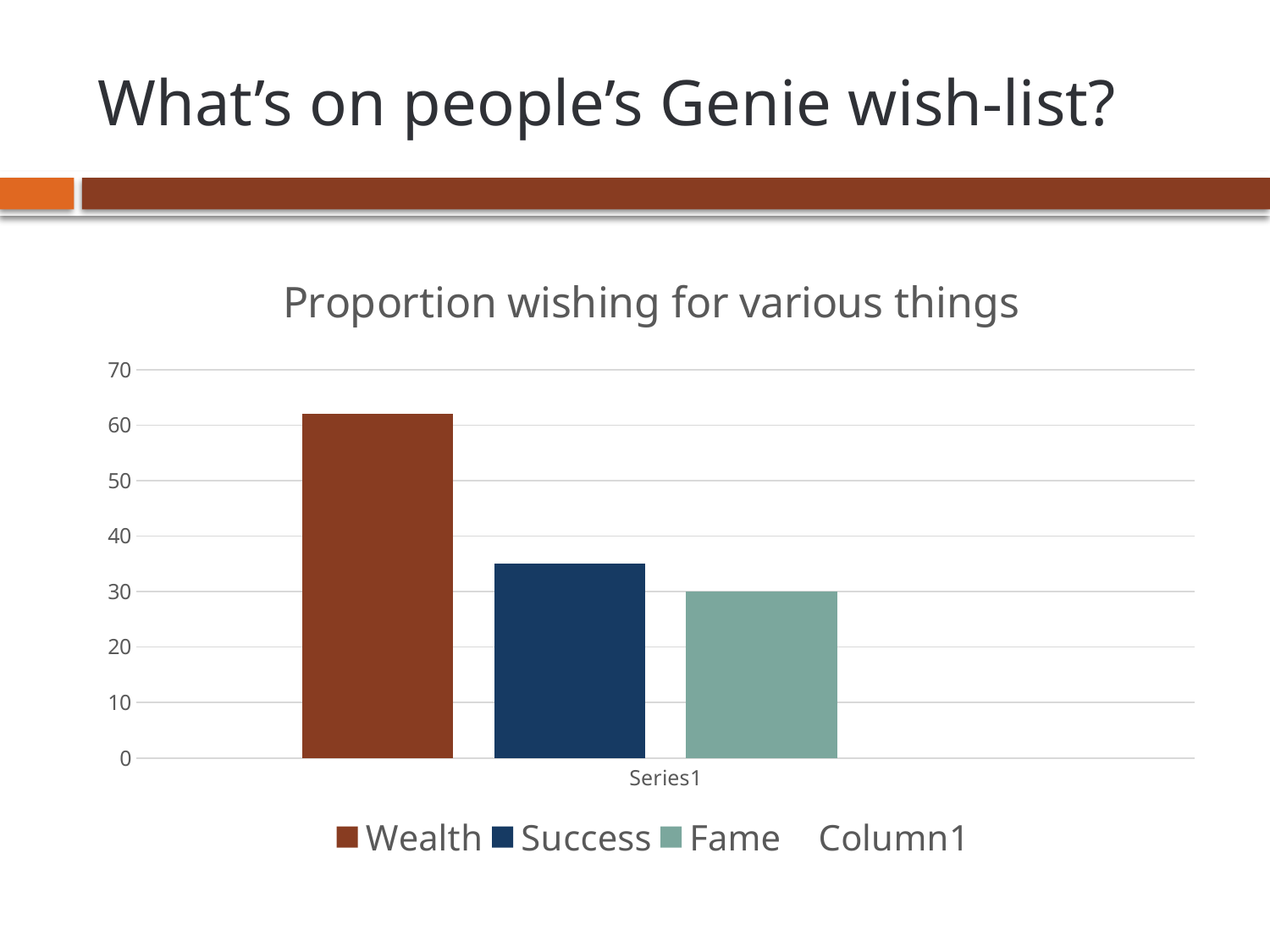
What is the title of the chart? Proportion wishing for various things Which is larger, the value for Success or the value for Fame? Success How many bars are plotted in the chart? 3 Which is larger, the value for Wealth or the value for Success? Wealth Which series has the lowest bar? Fame Which series has the highest bar? Wealth Is the value for Wealth greater or less than 70? less What kind of chart is shown on the slide? bar chart What colour is the bar for Success? dark blue How many entries does the legend list? 4 Is the value for Wealth greater or less than 60? greater Is the value for Success greater or less than 40? less